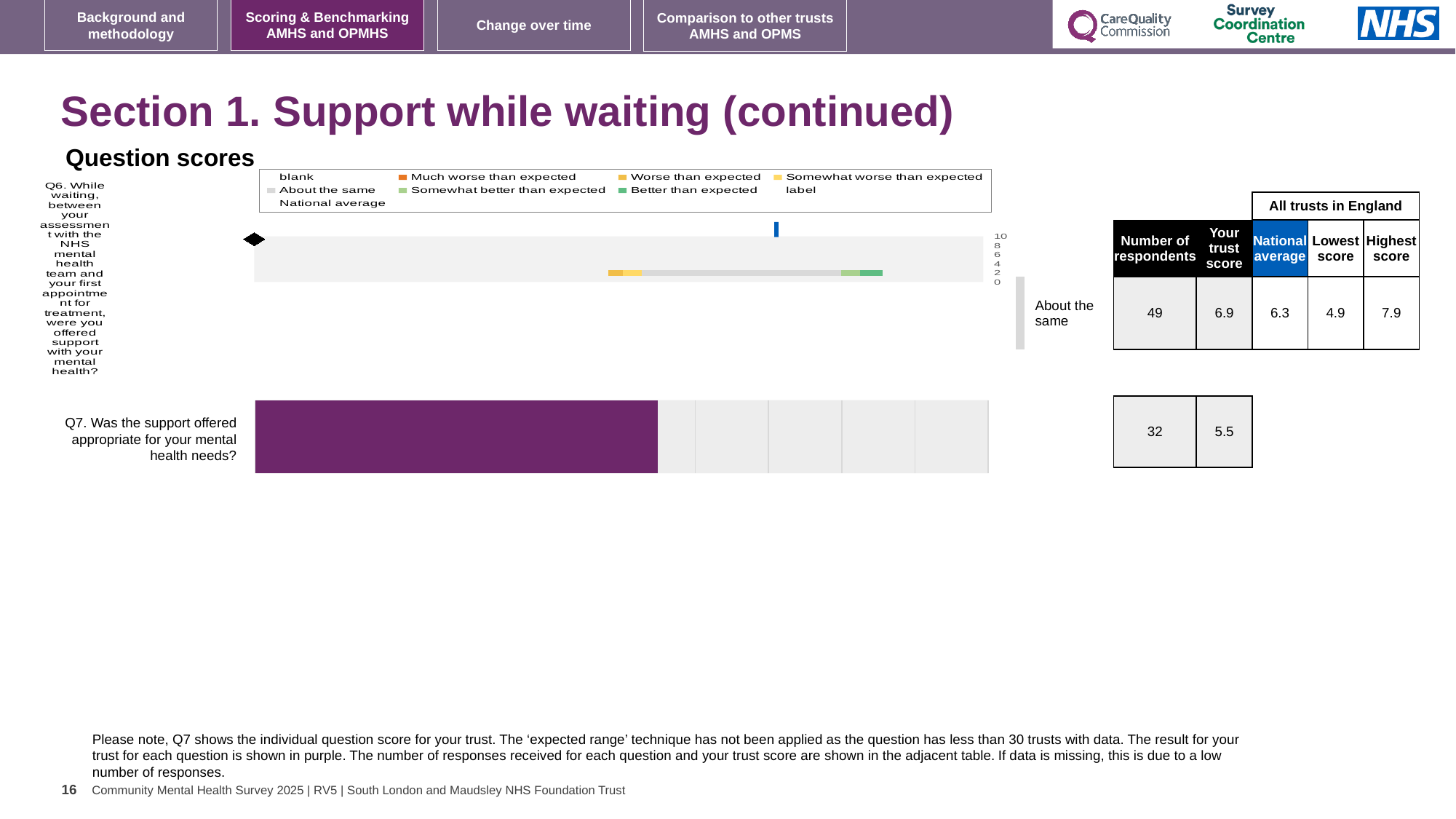
For Q6, what is the difference between the trust score and the national average? 0.6 For Q6, is the trust score higher or lower than the national average? higher What is the trust score for Q7 (was the support offered appropriate for your mental health needs)? 5.5 What is the highest score among all trusts in England for Q6? 7.9 What is the national average score for Q6? 6.3 What is the trust score for Q6 (support while waiting between assessment and first appointment)? 6.9 For Q6, what is the difference between the highest and lowest scores among all trusts in England? 3.0 How many respondents answered Q7? 32 What is the lowest score among all trusts in England for Q6? 4.9 How many respondents answered Q6? 49 What category label is shown next to the Q6 chart describing how the trust compares to expected? About the same Is the value of the purple bar for Q7 greater or less than 6? less